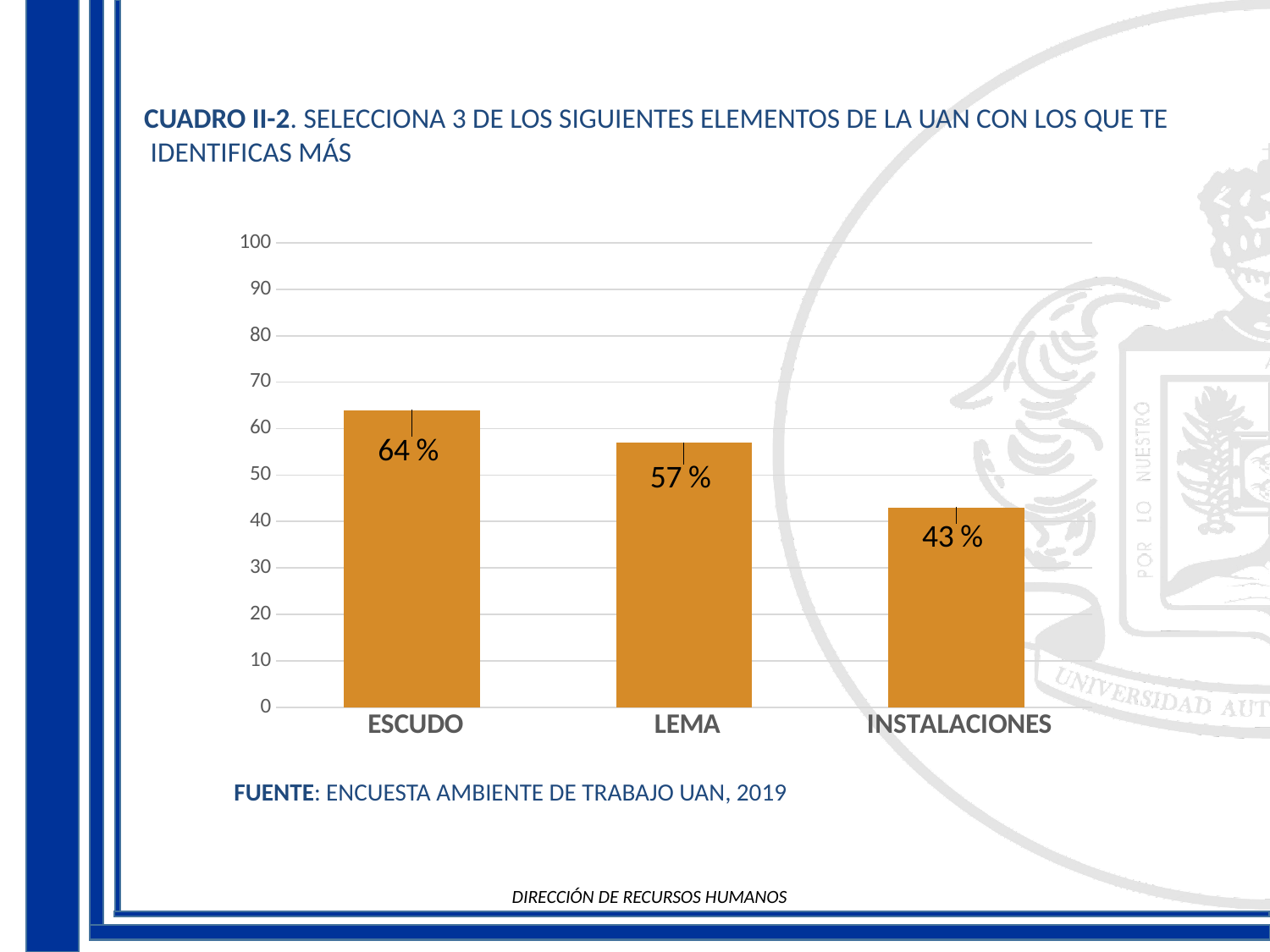
Which category has the highest value? ESCUDO What is the difference between the values for ESCUDO and INSTALACIONES? 21 % Which category has the lowest value? INSTALACIONES Is the value for LEMA greater or less than 50? greater What kind of chart is shown on the slide? bar chart Do the values rise or fall from left to right along the x axis? fall What is the value for INSTALACIONES? 43 % What is the difference between the values for ESCUDO and LEMA? 7 % What is the value for LEMA? 57 % Which is larger, the value for LEMA or the value for INSTALACIONES? LEMA What is the value for ESCUDO? 64 % How many categories are shown on the x axis? 3